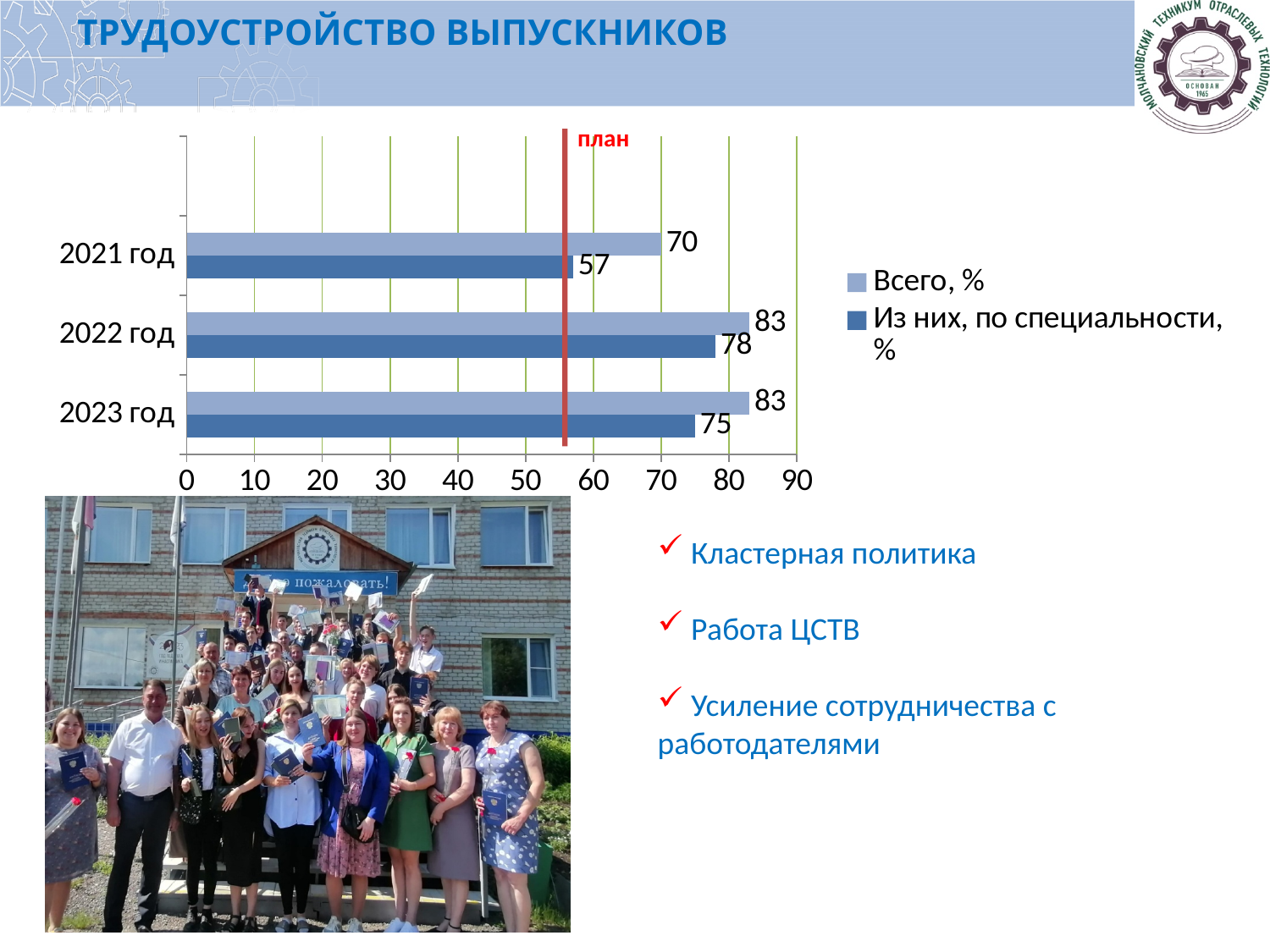
How many years (categories) are shown on the chart? 3 Which year has the lowest value for "Всего, %"? 2021 год What is the label of the red vertical line on the chart? план What is the value of "Всего, %" for 2021 год? 70 What is the difference between "Всего, %" and "Из них, по специальности, %" for 2021 год? 13 Which year has the highest value for "Из них, по специальности, %"? 2022 год What type of chart is shown on the slide? Bar chart How many series does the legend list? 2 What is the value of "Из них, по специальности, %" for 2021 год? 57 What is the value of "Из них, по специальности, %" for 2022 год? 78 What is the value of "Всего, %" for 2023 год? 83 Is the value of "Из них, по специальности, %" larger for 2022 год or for 2023 год? 2022 год